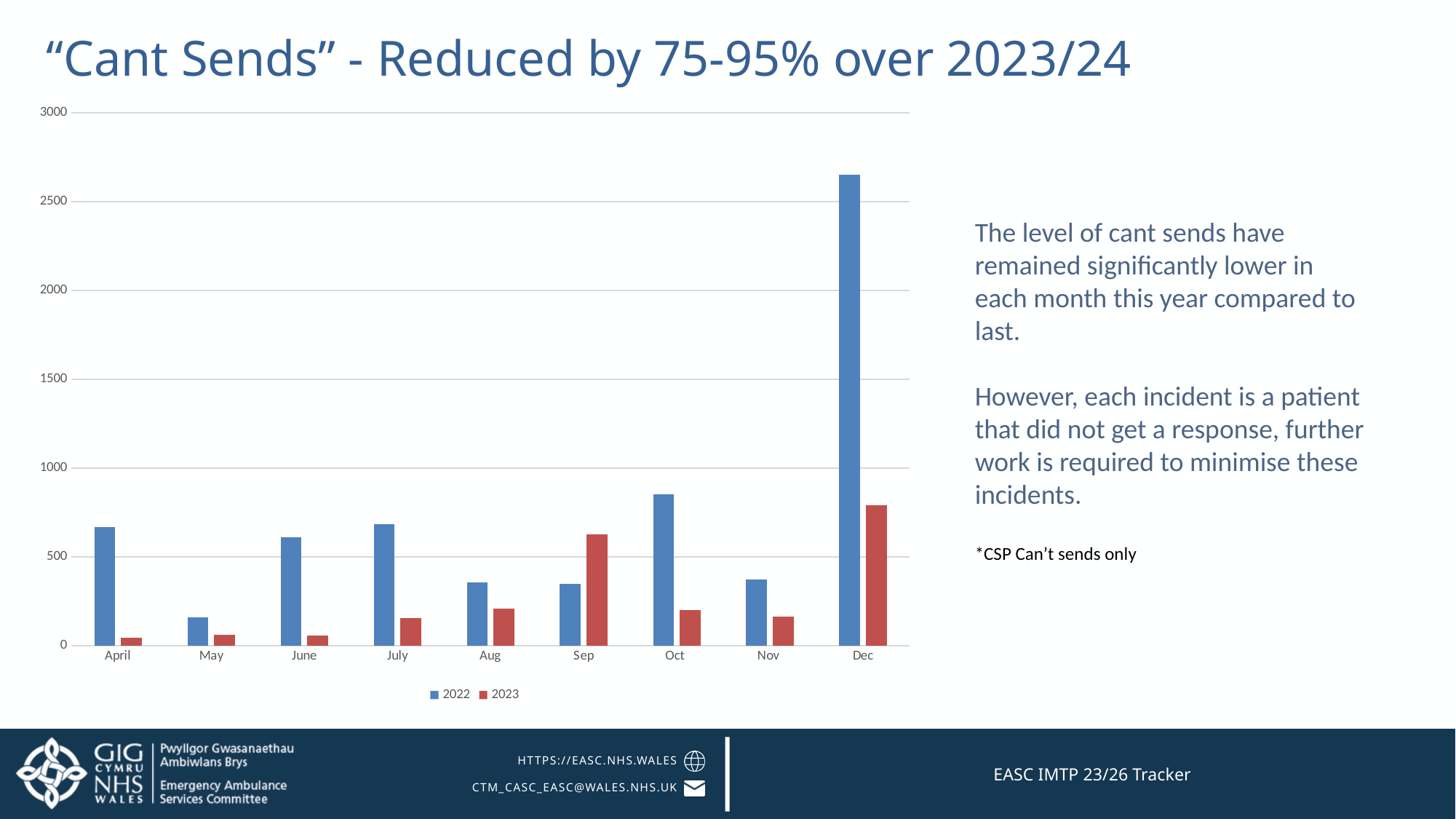
Which month has the highest 2023 value? Dec Is the 2023 value for Sep greater or less than 500? greater How many series does the chart's legend list? 2 Which month has the highest 2022 value? Dec Is the 2022 value for Dec greater or less than 2500? greater In Sep, which series has the larger value, 2022 or 2023? 2023 What kind of chart is shown on the slide? bar chart Which month has the lowest 2022 value? May In Dec, which series has the larger value, 2022 or 2023? 2022 How many months are shown on the x axis of the chart? 9 Is the 2022 value for Oct greater or less than 1000? less What are the two entries in the chart's legend? 2022 and 2023